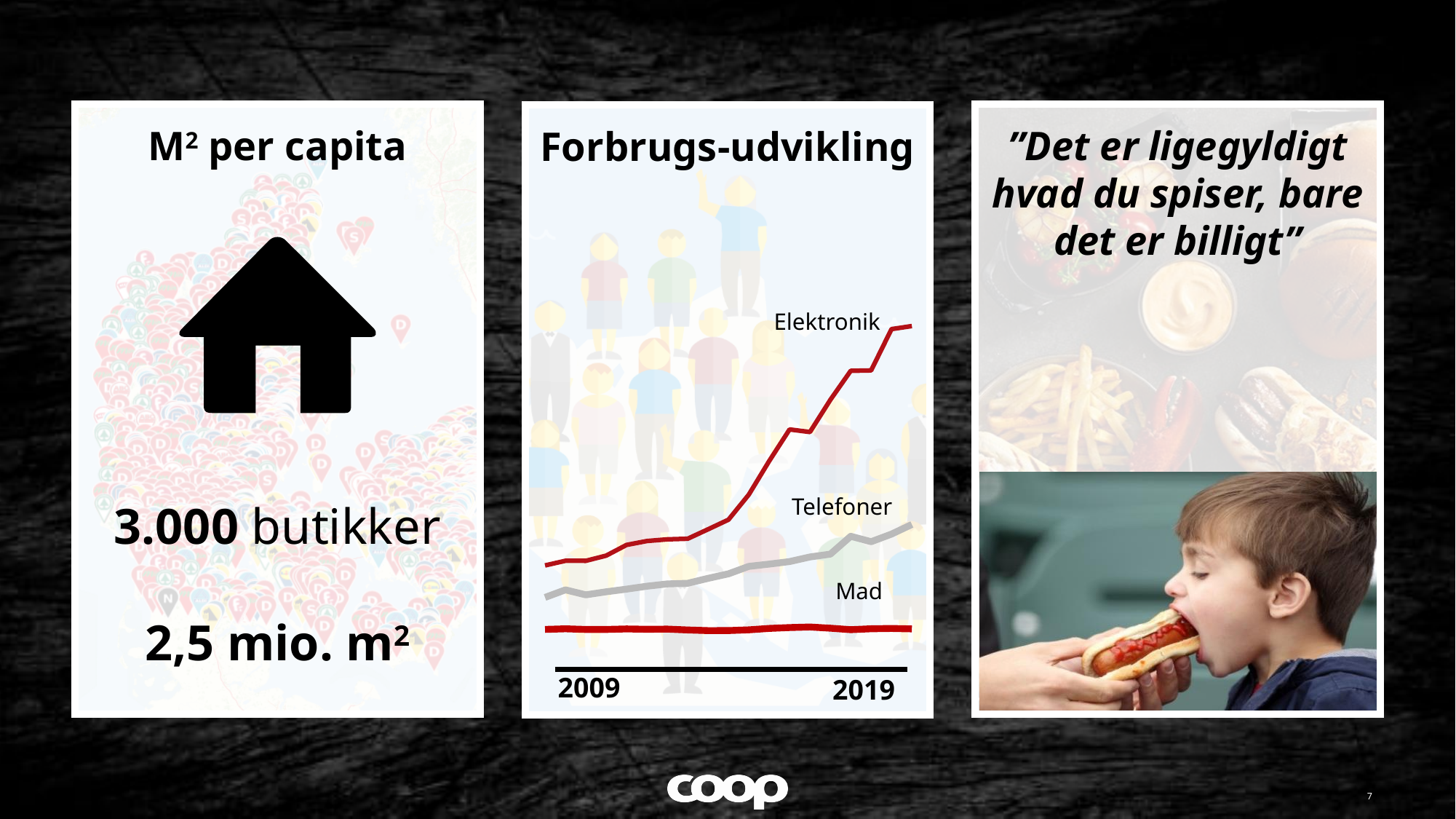
In the "Forbrugs-udvikling" chart, does the Elektronik line rise or fall from 2009 to 2019? rise What kind of chart is shown in the "Forbrugs-udvikling" panel? line chart How many series are plotted in the "Forbrugs-udvikling" chart? 3 What is the title of the chart on the slide? Forbrugs-udvikling Which series in the "Forbrugs-udvikling" chart is lowest at the right end of the x axis? Mad In the "Forbrugs-udvikling" chart, which is higher in 2019: Elektronik or Telefoner? Elektronik In the "Forbrugs-udvikling" chart, does the Telefoner line rise or fall from 2009 to 2019? rise In the "Forbrugs-udvikling" chart, which is higher in 2019: Telefoner or Mad? Telefoner In the "Forbrugs-udvikling" chart, does the Mad line rise noticeably, fall noticeably, or stay roughly flat from 2009 to 2019? stay roughly flat Which series in the "Forbrugs-udvikling" chart is highest at the right end of the x axis? Elektronik What are the first and last years labelled on the x axis of the "Forbrugs-udvikling" chart? 2009 and 2019